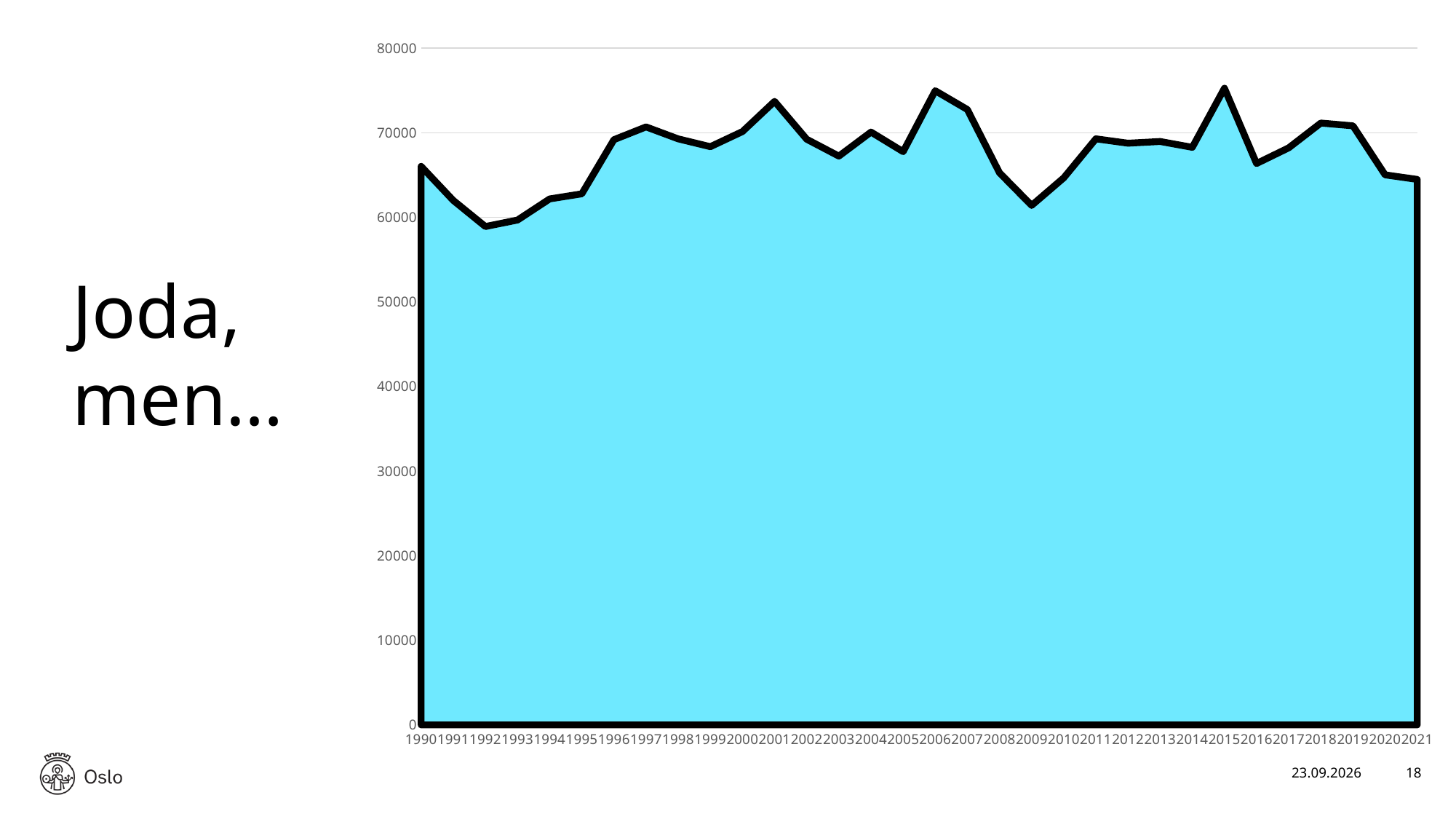
Is the value for 2015 greater or less than 70000? greater Which is larger, the value for 2009 or the value for 2015? 2015 What is the highest value shown on the y axis of the chart? 80000 How many years are plotted along the x axis of the chart? 32 Is the value for 1992 greater or less than 60000? less Is the value for 2006 greater or less than 70000? greater Which is larger, the value for 1990 or the value for 1992? 1990 Do the values rise or fall from 2006 to 2009? fall Which year has the lowest value in the chart? 1992 What kind of chart is shown on the slide? Area chart